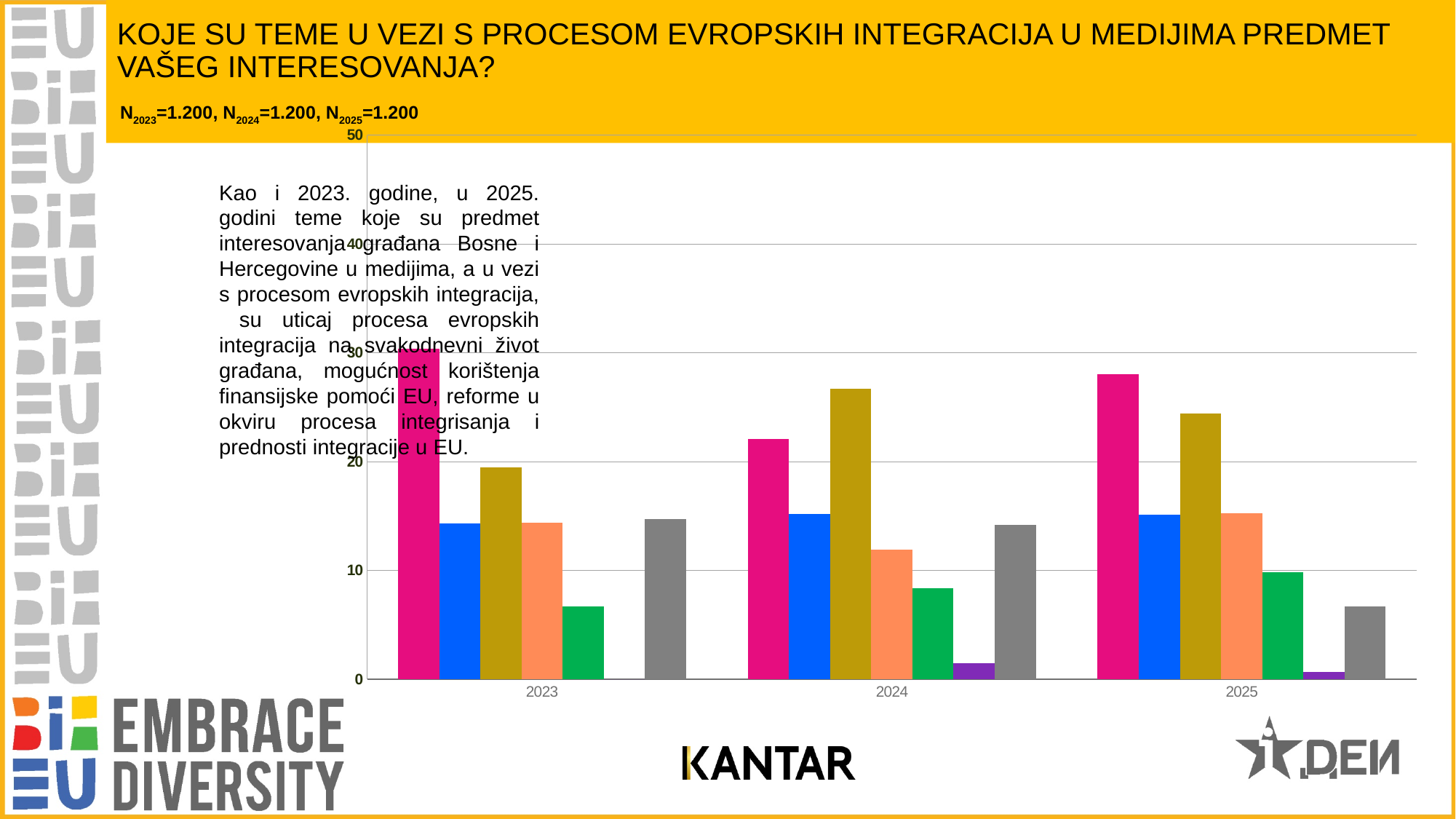
In which year is the gold bar the tallest? 2024 Is the value of the orange bar for 2024 greater or less than 10? greater Is the value of the gold bar for 2024 greater or less than 20? greater Do the green bars rise or fall from 2023 to 2025? rise How many year categories are shown on the x axis of the chart? 3 Is the value of the grey bar for 2025 greater or less than 10? less In 2025, which is larger: the pink bar or the gold bar? the pink bar In 2024, which is larger: the pink bar or the gold bar? the gold bar Which is larger: the grey bar for 2024 or the grey bar for 2025? the grey bar for 2024 What kind of chart is shown on the slide? bar chart